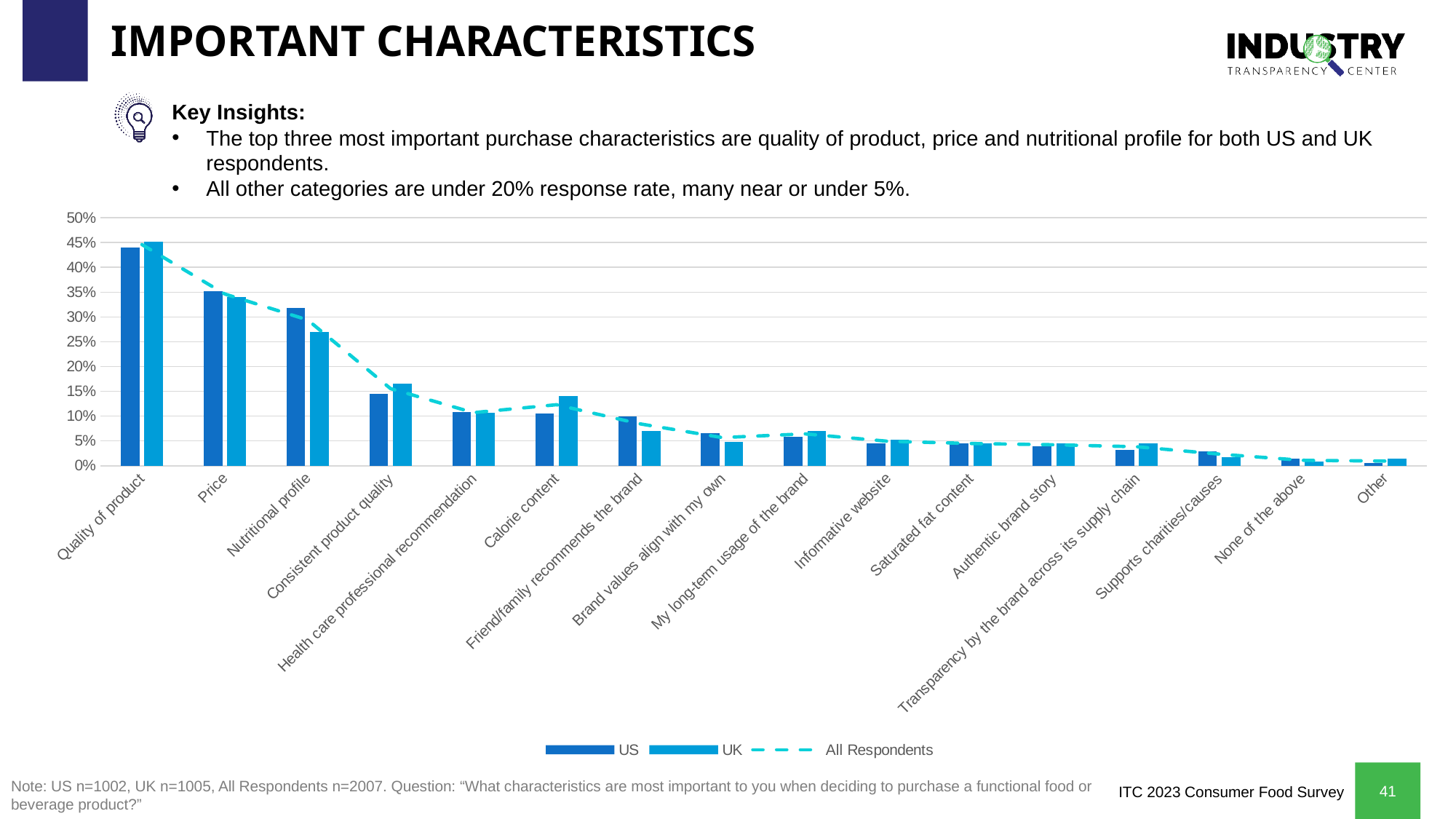
How many series does the legend list? 3 Is the US value for Quality of product greater or less than 40%? greater How many characteristic categories are shown on the x axis? 16 What kind of chart is shown on the slide? Bar chart with a dashed line Which characteristic has the highest US value? Quality of product For Nutritional profile, which is larger, the US value or the UK value? US Is the UK value for Nutritional profile greater or less than 30%? less For Calorie content, which is larger, the US value or the UK value? UK Do the values generally rise or fall moving from left to right along the x axis? Fall Which characteristic has the lowest US value? Other Is the UK value for Consistent product quality greater or less than 20%? less